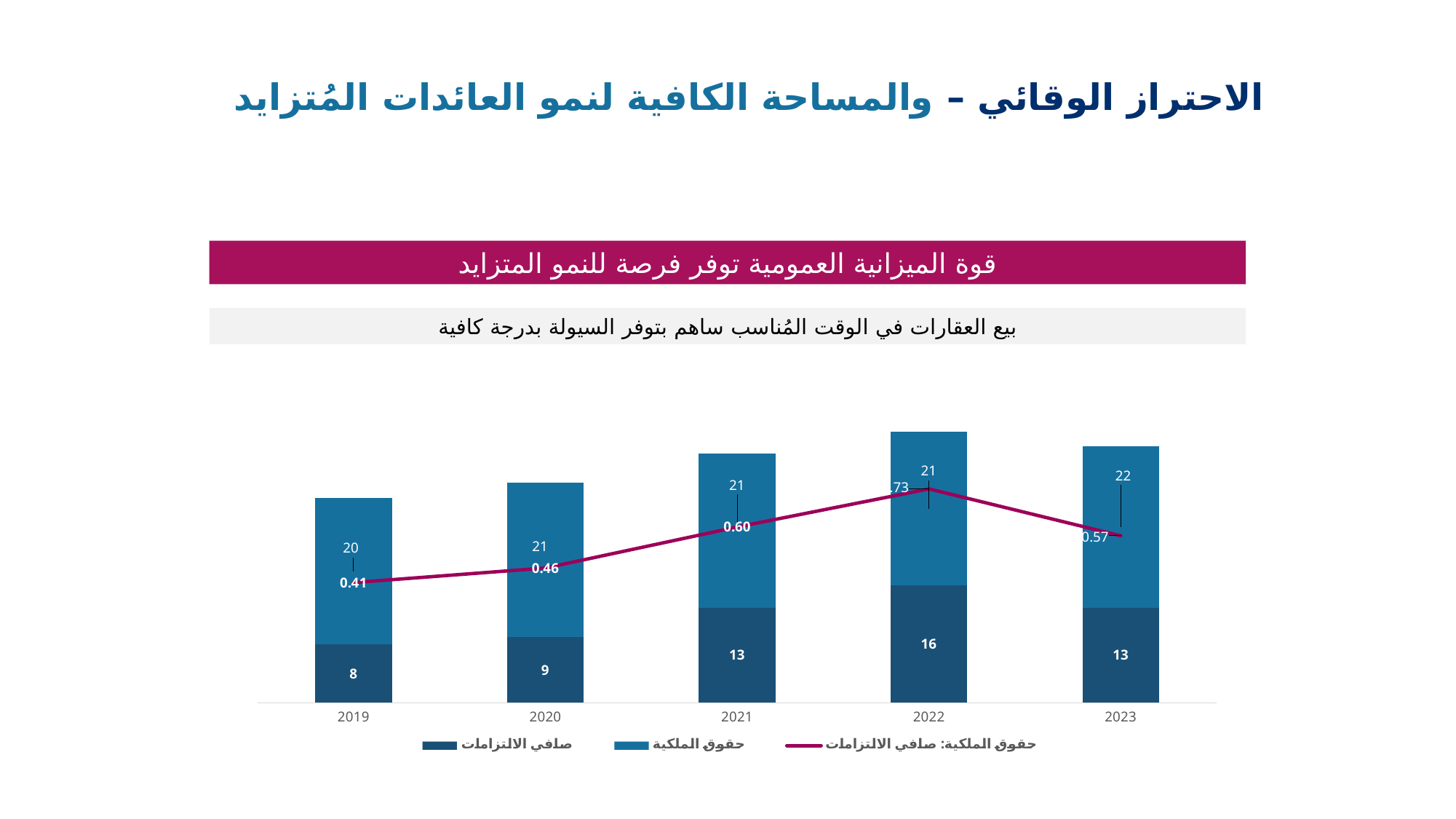
What is the value of the حقوق الملكية: صافي الالتزامات line for 2019? 0.41 What kind of chart is shown on the slide? Stacked bar chart with a line How many years are shown on the x axis? 5 What is the value of صافي الالتزامات for 2022? 16 Which year has the lowest value for حقوق الملكية? 2019 What is the value of the حقوق الملكية: صافي الالتزامات line for 2021? 0.60 What is the value of حقوق الملكية for 2023? 22 What is the total of the stacked bar for 2022? 37 How many series does the legend list? 3 What is the difference between صافي الالتزامات in 2022 and in 2019? 8 Which is larger: صافي الالتزامات in 2021 or in 2020? 2021 Which year has the highest value for صافي الالتزامات? 2022